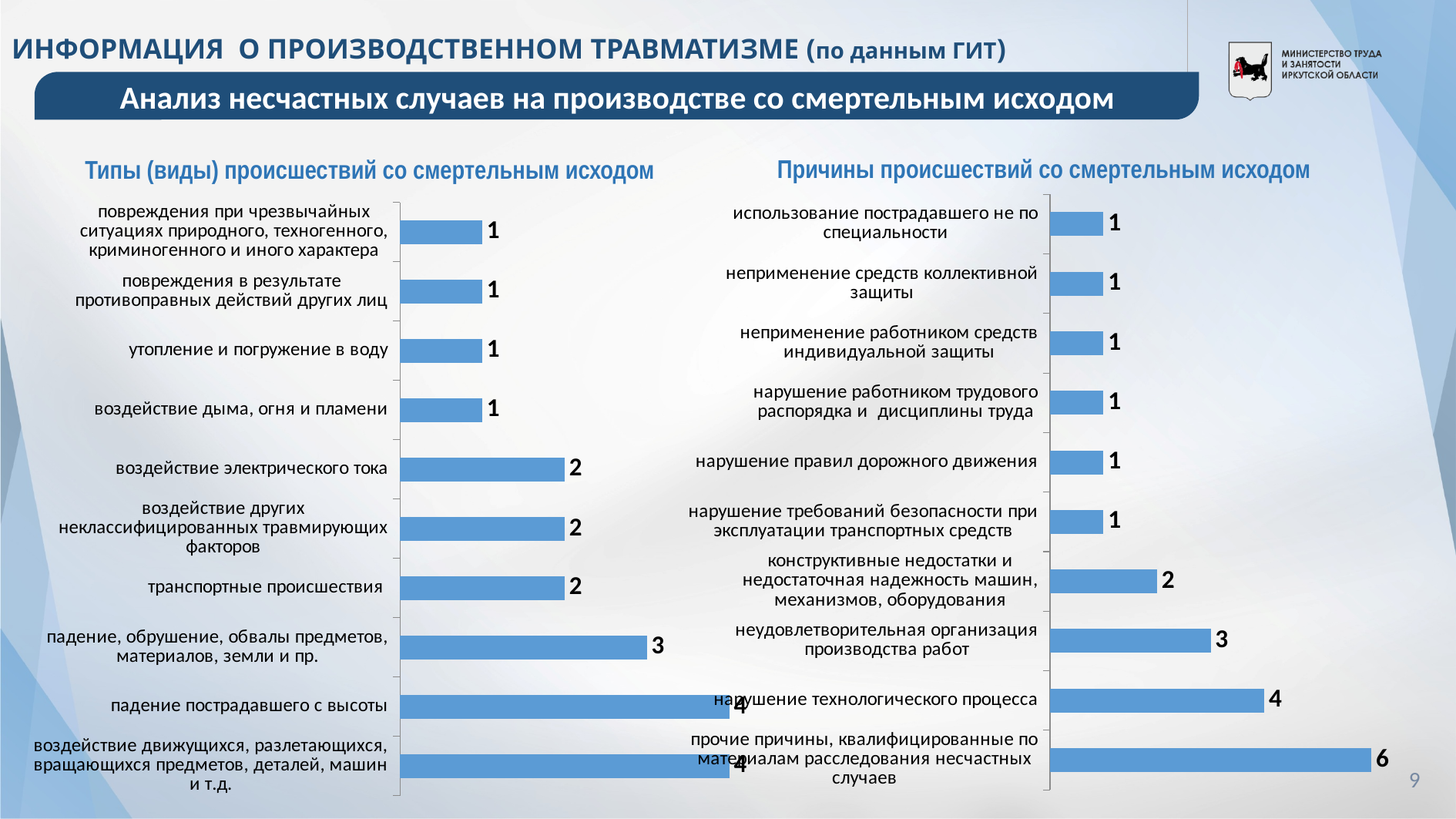
In the chart 'Типы (виды) происшествий со смертельным исходом', what is the value for 'падение пострадавшего с высоты'? 4 In the chart 'Причины происшествий со смертельным исходом', what is the value for 'конструктивные недостатки и недостаточная надежность машин, механизмов, оборудования'? 2 How many categories are shown in the chart 'Причины происшествий со смертельным исходом'? 10 In the chart 'Типы (виды) происшествий со смертельным исходом', what is the value for 'падение, обрушение, обвалы предметов, материалов, земли и пр.'? 3 How many categories are shown in the chart 'Типы (виды) происшествий со смертельным исходом'? 10 In the chart 'Причины происшествий со смертельным исходом', what is the value for 'неудовлетворительная организация производства работ'? 3 In the chart 'Типы (виды) происшествий со смертельным исходом', which is larger: 'транспортные происшествия' or 'падение, обрушение, обвалы предметов, материалов, земли и пр.'? падение, обрушение, обвалы предметов, материалов, земли и пр. In the chart 'Причины происшествий со смертельным исходом', which cause has the highest value? прочие причины, квалифицированные по материалам расследования несчастных случаев In the chart 'Причины происшествий со смертельным исходом', what is the difference between 'прочие причины, квалифицированные по материалам расследования несчастных случаев' and 'нарушение технологического процесса'? 2 In the chart 'Причины происшествий со смертельным исходом', what is the value for 'нарушение технологического процесса'? 4 What type of chart is 'Причины происшествий со смертельным исходом'? bar chart In the chart 'Типы (виды) происшествий со смертельным исходом', what is the value for 'воздействие электрического тока'? 2